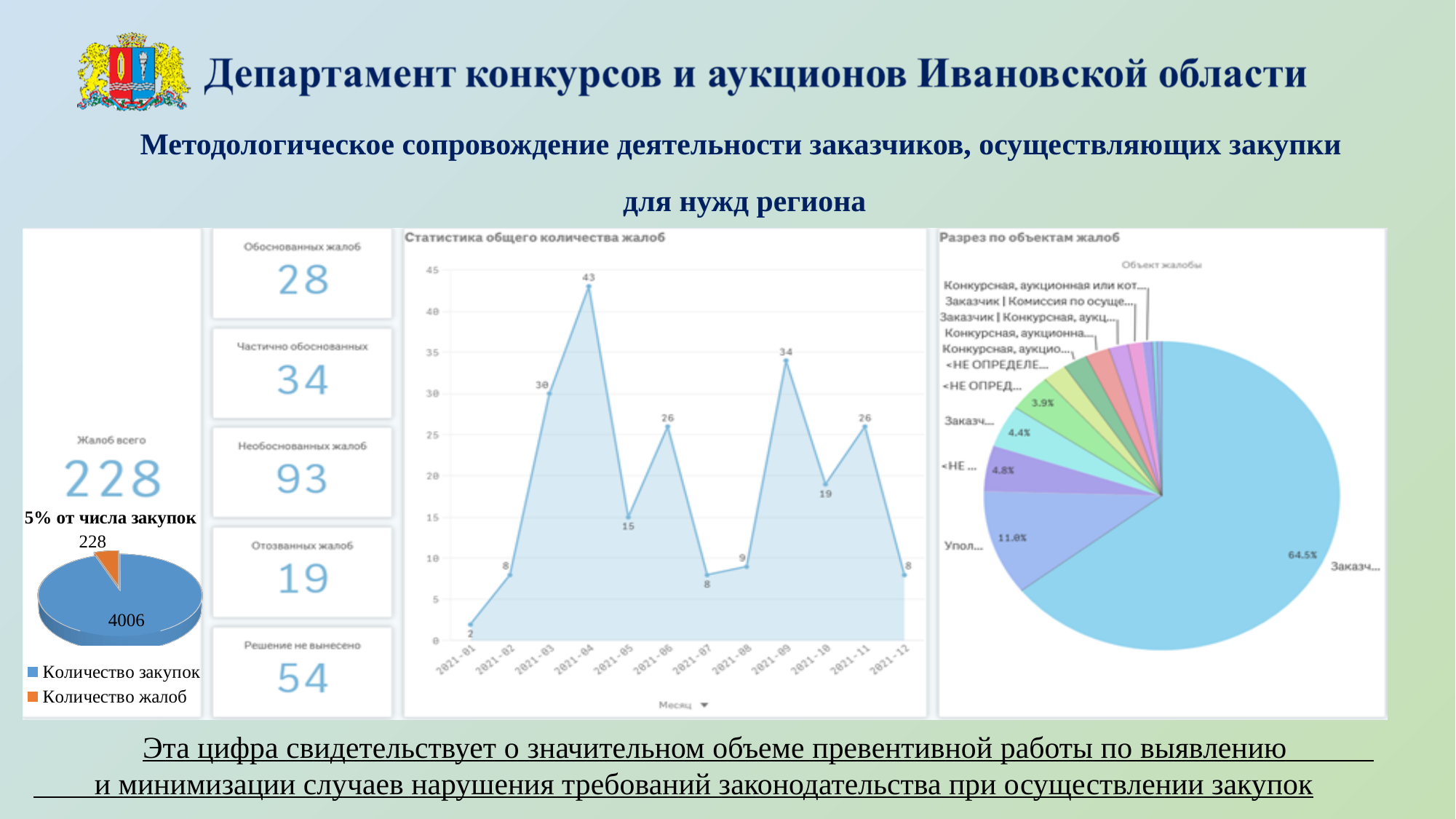
In the pie chart titled "Разрез по объектам жалоб", what is the share of the slice labelled "Упол..."? 11.0% In the chart titled "Статистика общего количества жалоб", how many months are plotted on the x axis? 12 In the chart titled "Статистика общего количества жалоб", which month has the lowest value? 2021-01 In the chart titled "Статистика общего количества жалоб", what is the value for 2021-04? 43 In the small pie chart at the bottom left of the slide, what is the value for "Количество закупок"? 4006 In the pie chart titled "Разрез по объектам жалоб", what is the share of the largest slice? 64.5% How many series does the legend of the small pie chart at the bottom left of the slide list? 2 In the chart titled "Статистика общего количества жалоб", what is the value for 2021-09? 34 In the chart titled "Статистика общего количества жалоб", what is the difference between the values for 2021-04 and 2021-03? 13 In the chart titled "Статистика общего количества жалоб", which is larger, the value for 2021-06 or the value for 2021-10? 2021-06 In the chart titled "Статистика общего количества жалоб", do the values rise or fall from 2021-01 to 2021-04? rise In the chart titled "Статистика общего количества жалоб", which month has the highest value? 2021-04